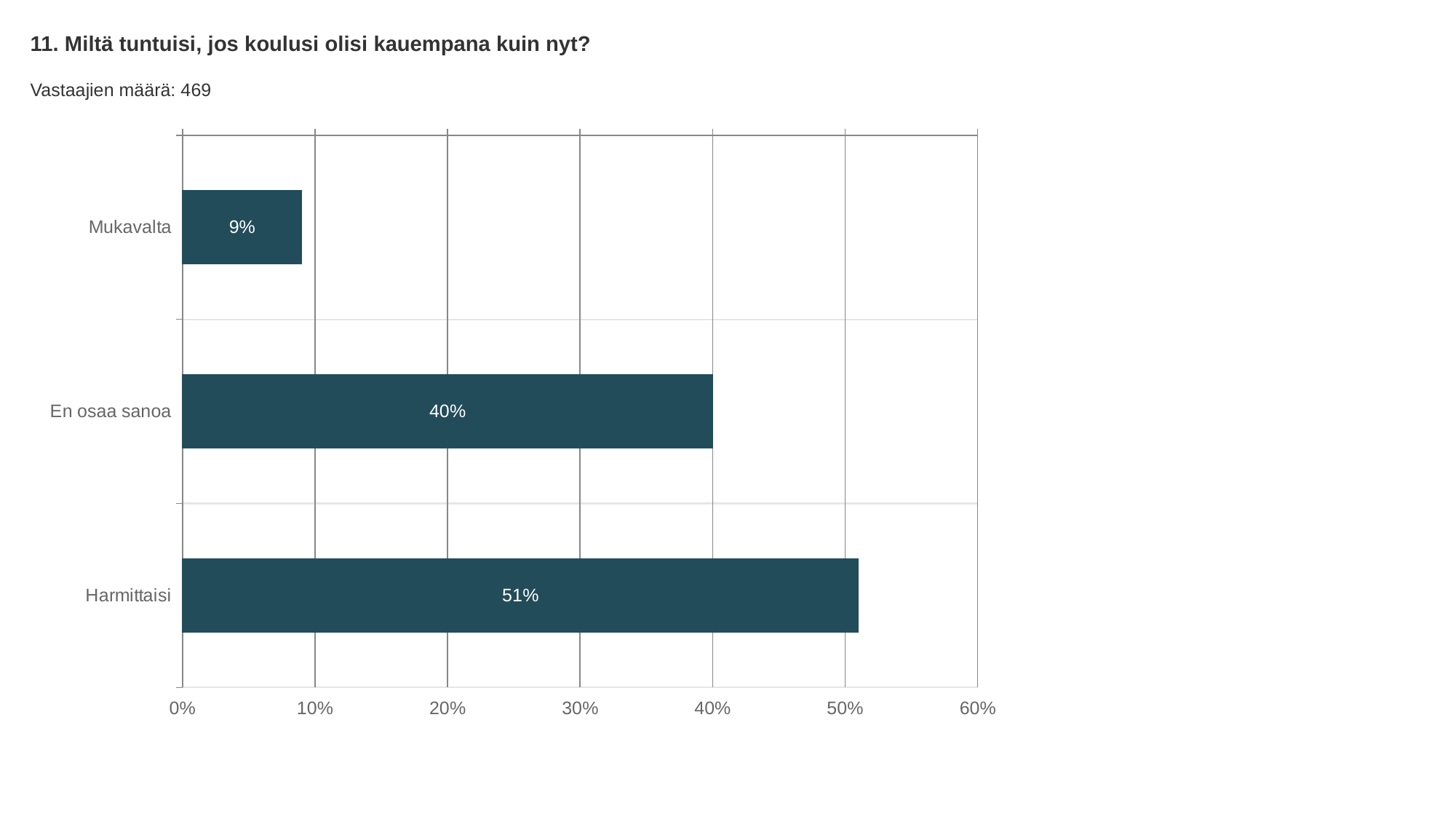
What is the difference between the values for Harmittaisi and En osaa sanoa? 11% Which category has the lowest value? Mukavalta What kind of chart is shown on the slide? bar chart How many respondents (Vastaajien määrä) are reported on the slide? 469 What is the value for En osaa sanoa? 40% Is the value for Harmittaisi greater or less than 50%? greater What is the value for Mukavalta? 9% How many categories are shown in the chart? 3 What is the value for Harmittaisi? 51% Which is larger, the value for Mukavalta or the value for En osaa sanoa? En osaa sanoa What is the difference between the values for En osaa sanoa and Mukavalta? 31% Which category has the highest value? Harmittaisi